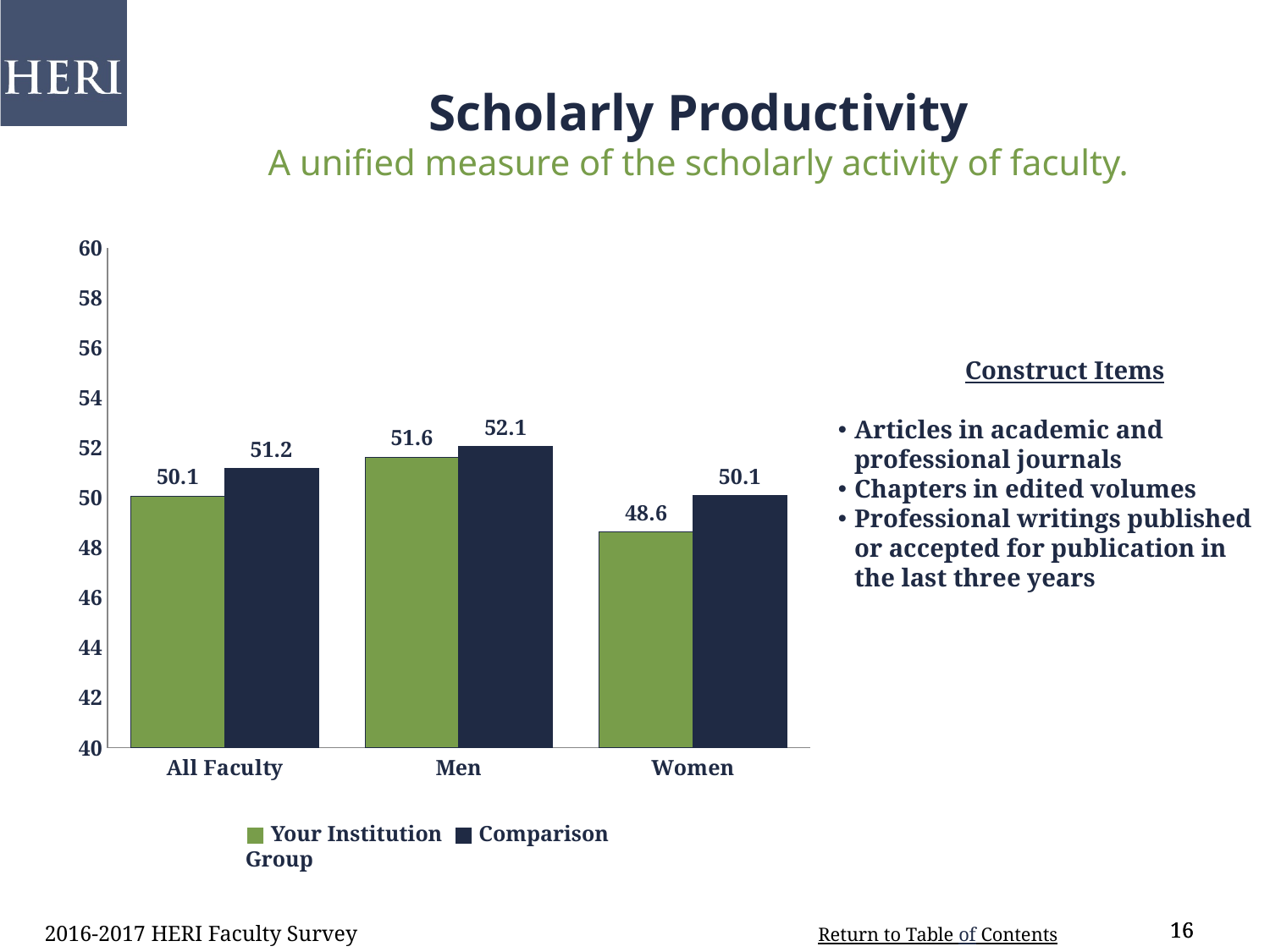
Which category has the lowest Your Institution value? Women What is the difference between the Comparison Group and Your Institution values for All Faculty? 1.1 What is the difference between the Comparison Group and Your Institution values for Women? 1.5 How many series does the legend list? 2 What kind of chart is shown on the slide? bar chart Is the Your Institution value for Women greater or less than 50? less How many categories are shown on the x axis? 3 What is the Your Institution value for Men? 51.6 Which is larger for Men: Your Institution or Comparison Group? Comparison Group What is the Your Institution value for All Faculty? 50.1 Which category has the highest Comparison Group value? Men What is the Comparison Group value for Women? 50.1